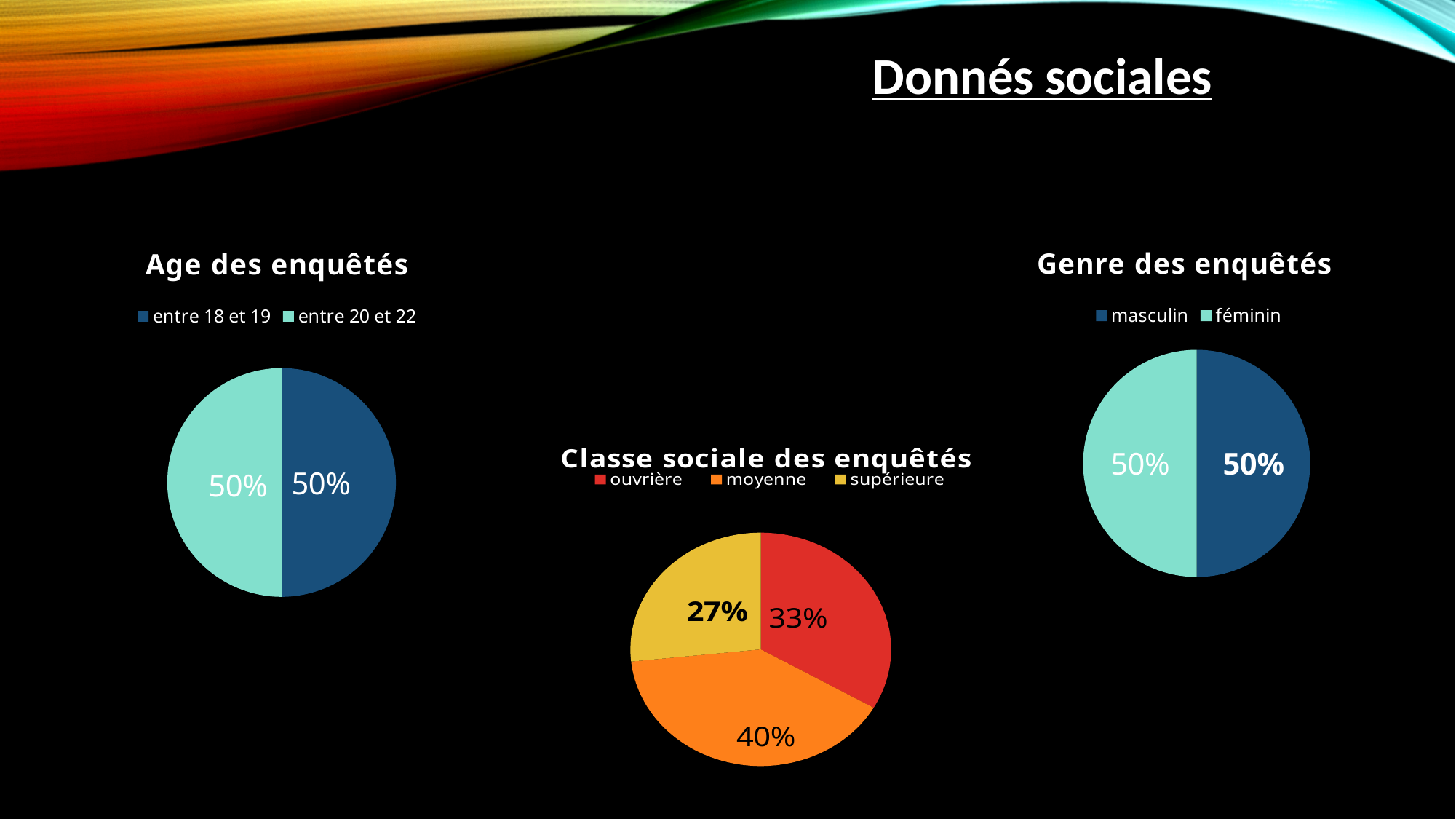
In the 'Classe sociale des enquêtés' chart, what share is labelled for 'ouvrière'? 33% What kind of chart is 'Genre des enquêtés'? Pie chart In the 'Classe sociale des enquêtés' chart, which is larger: 'ouvrière' or 'moyenne'? moyenne How many categories does the 'Classe sociale des enquêtés' chart show? 3 In the 'Classe sociale des enquêtés' chart, what is the difference in percentage points between 'moyenne' and 'supérieure'? 13 In the 'Classe sociale des enquêtés' chart, which category has the largest slice? moyenne In the 'Classe sociale des enquêtés' chart, which category has the smallest slice? supérieure How many entries does the legend of the 'Age des enquêtés' chart list? 2 In the 'Genre des enquêtés' chart, what share is labelled for 'féminin'? 50% In the 'Classe sociale des enquêtés' chart, what share is labelled for 'supérieure'? 27% In the 'Classe sociale des enquêtés' chart, what share is labelled for 'moyenne'? 40% In the 'Age des enquêtés' chart, what share is labelled for 'entre 18 et 19'? 50%